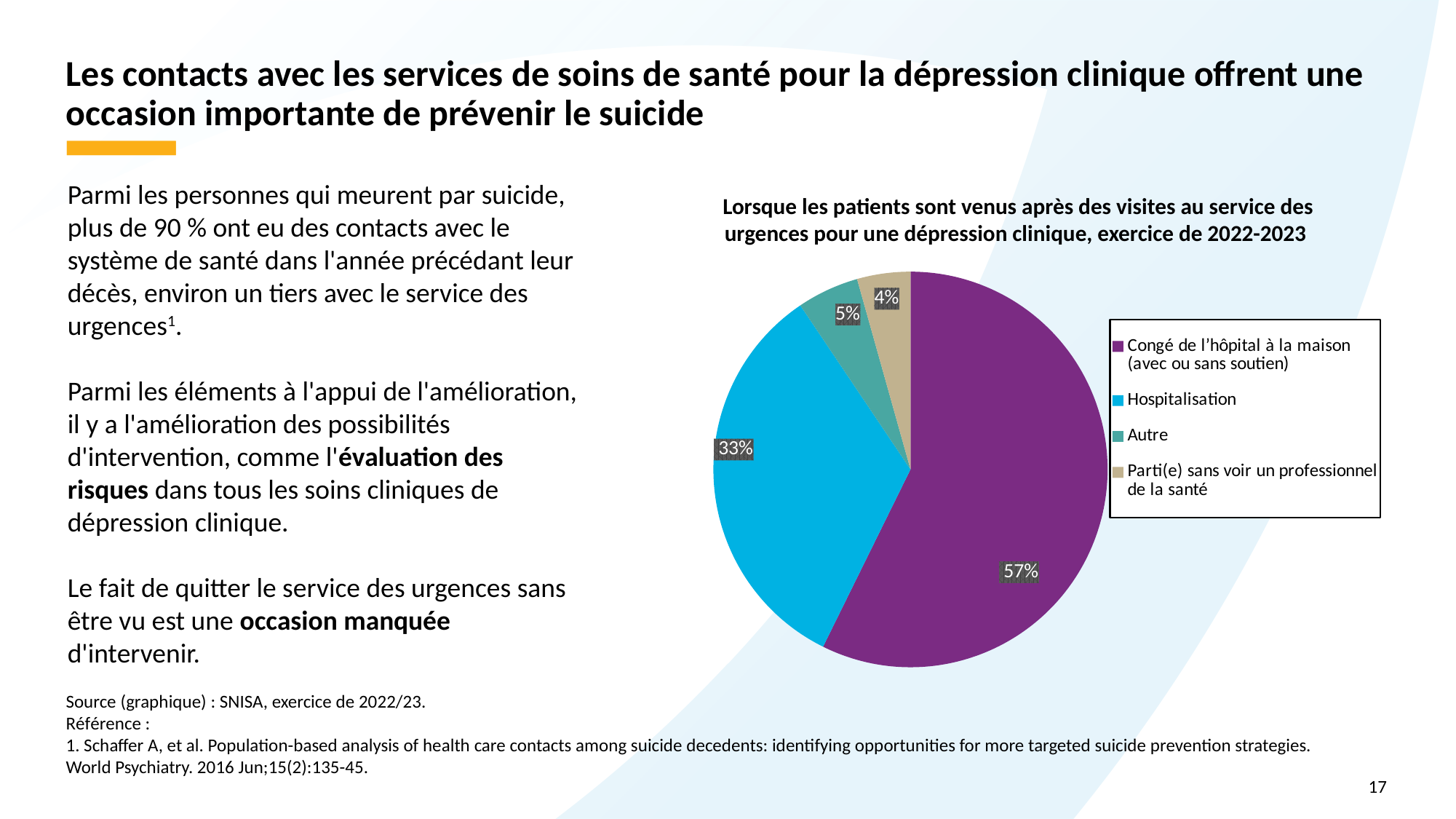
What percentage of patients were discharged home (Congé de l'hôpital à la maison, avec ou sans soutien)? 57% How many categories does the pie chart show? 4 What percentage of patients left without seeing a health professional (Parti(e) sans voir un professionnel de la santé)? 4% Which category has the smallest share of the pie? Parti(e) sans voir un professionnel de la santé What percentage is shown for the 'Autre' category? 5% What is the title of the pie chart? Lorsque les patients sont venus après des visites au service des urgences pour une dépression clinique, exercice de 2022-2023 What percentage of patients were hospitalized (Hospitalisation)? 33% What is the difference in percentage points between 'Congé de l'hôpital à la maison' and 'Hospitalisation'? 24% What kind of chart is shown on the slide? Pie chart What colour represents 'Hospitalisation' in the pie chart? Blue Which is larger: the share for 'Autre' or the share for 'Parti(e) sans voir un professionnel de la santé'? Autre Which category has the largest share of the pie? Congé de l'hôpital à la maison (avec ou sans soutien)